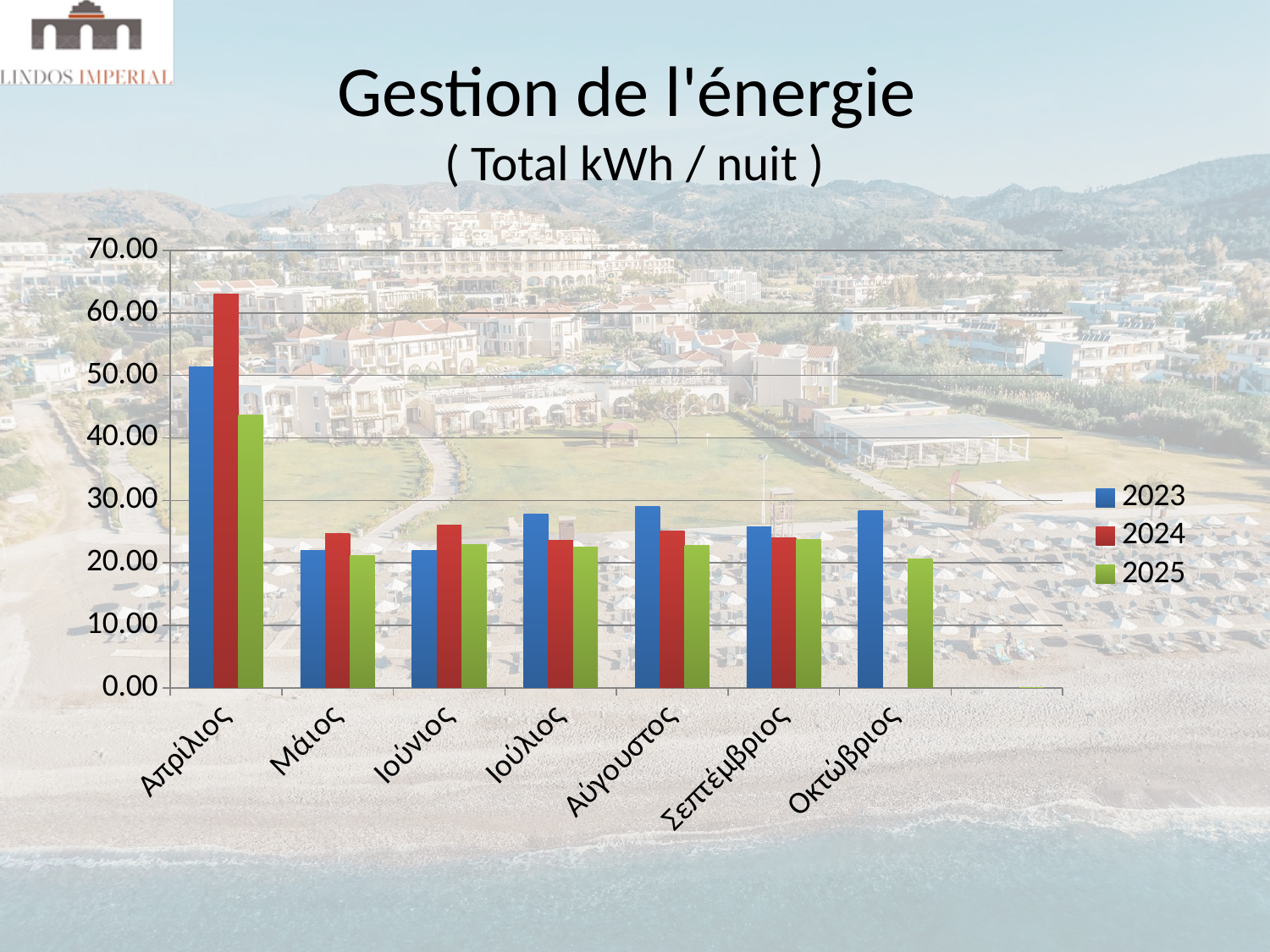
Is the 2023 value for Απρίλιος greater or less than 50.00? greater How many month categories are shown on the x axis? 7 How many series does the legend list? 3 For Απρίλιος, which series has the larger value, 2023 or 2025? 2023 Is the 2024 value for Απρίλιος greater or less than 60.00? greater What is the title of the chart on the slide? Gestion de l'énergie ( Total kWh / nuit ) Which month has the highest value for the 2023 series? Απρίλιος Is the 2025 value for Μάιος greater or less than 30.00? less Which month has the highest value for the 2024 series? Απρίλιος What kind of chart is shown on the slide? bar chart For Ιούλιος, which series has the larger value, 2023 or 2025? 2023